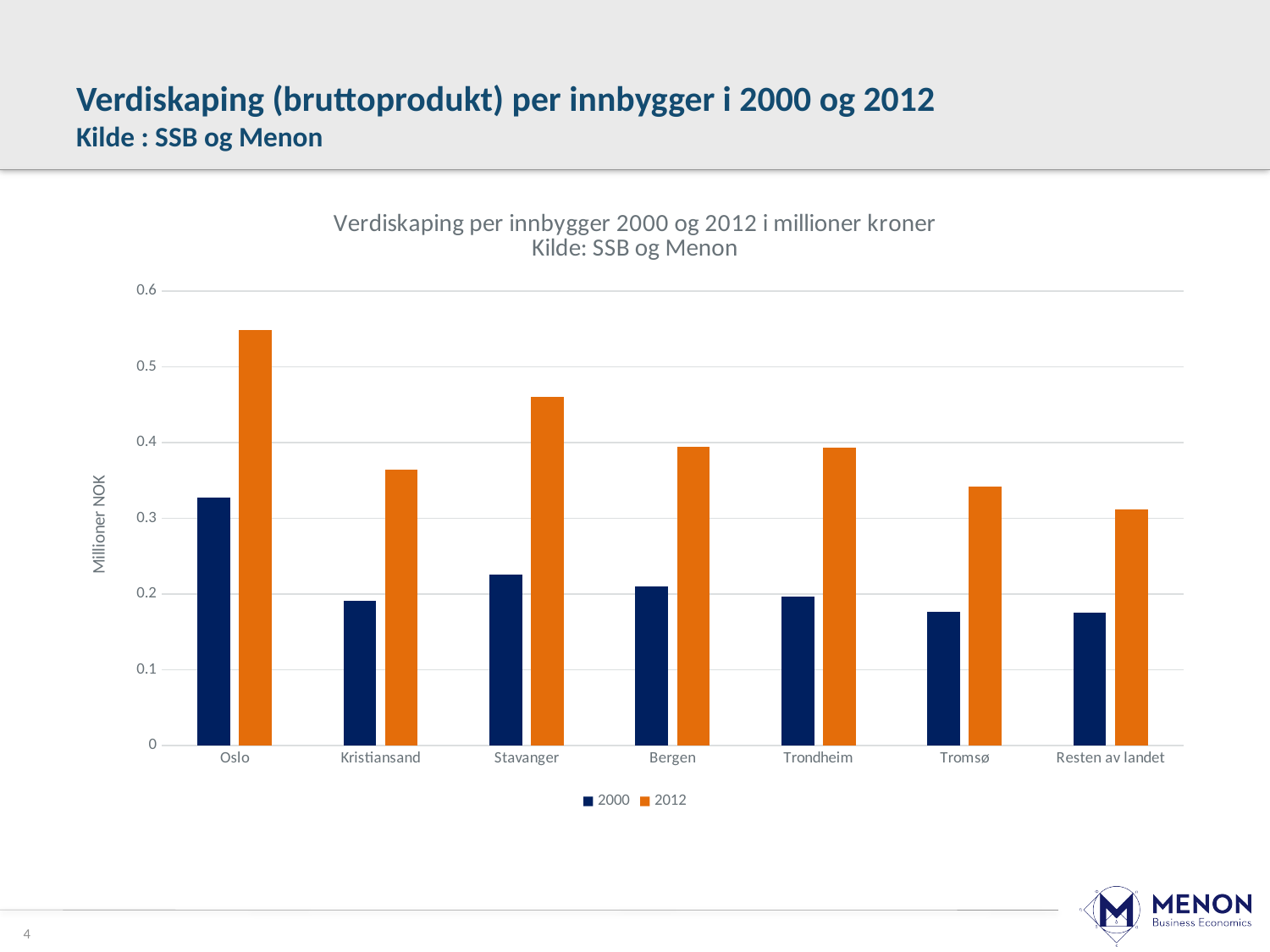
Is the 2012 value for Tromsø greater or less than 0.4? less Which category has the highest value for 2000? Oslo Which is larger, the 2012 value for Stavanger or the 2012 value for Kristiansand? Stavanger What is the label on the vertical axis? Millioner NOK How many categories are shown on the x axis? 7 Is the 2012 value for Stavanger greater or less than 0.4? greater Which category has the highest value for 2012? Oslo How many series does the legend list? 2 What kind of chart is shown on the slide? bar chart Is the 2012 value for Oslo greater or less than 0.5? greater Which category has the lowest value for 2012? Resten av landet